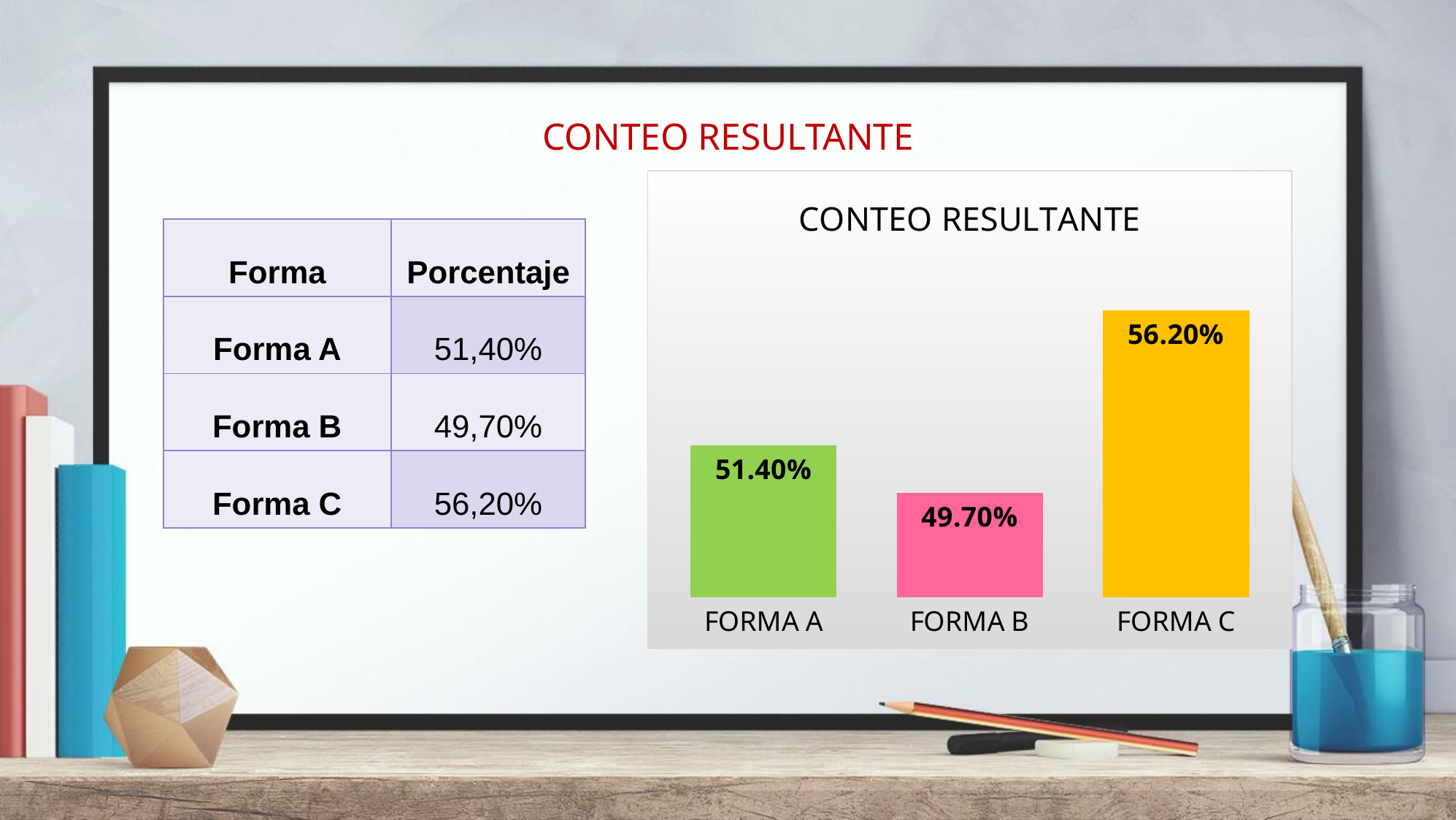
How many categories are shown in the chart? 3 Which is larger, the value for FORMA A or the value for FORMA B? FORMA A What is the difference between the values for FORMA C and FORMA A? 4.80% What is the title of the chart? CONTEO RESULTANTE What kind of chart is shown on the slide? Bar chart What is the value for FORMA C in the chart? 56.20% What is the difference between the values for FORMA A and FORMA B? 1.70% Which category has the lowest value in the chart? FORMA B What is the value for FORMA A in the chart? 51.40% Which category has the highest value in the chart? FORMA C What is the value for FORMA B in the chart? 49.70% What colour is the bar for FORMA C? Yellow